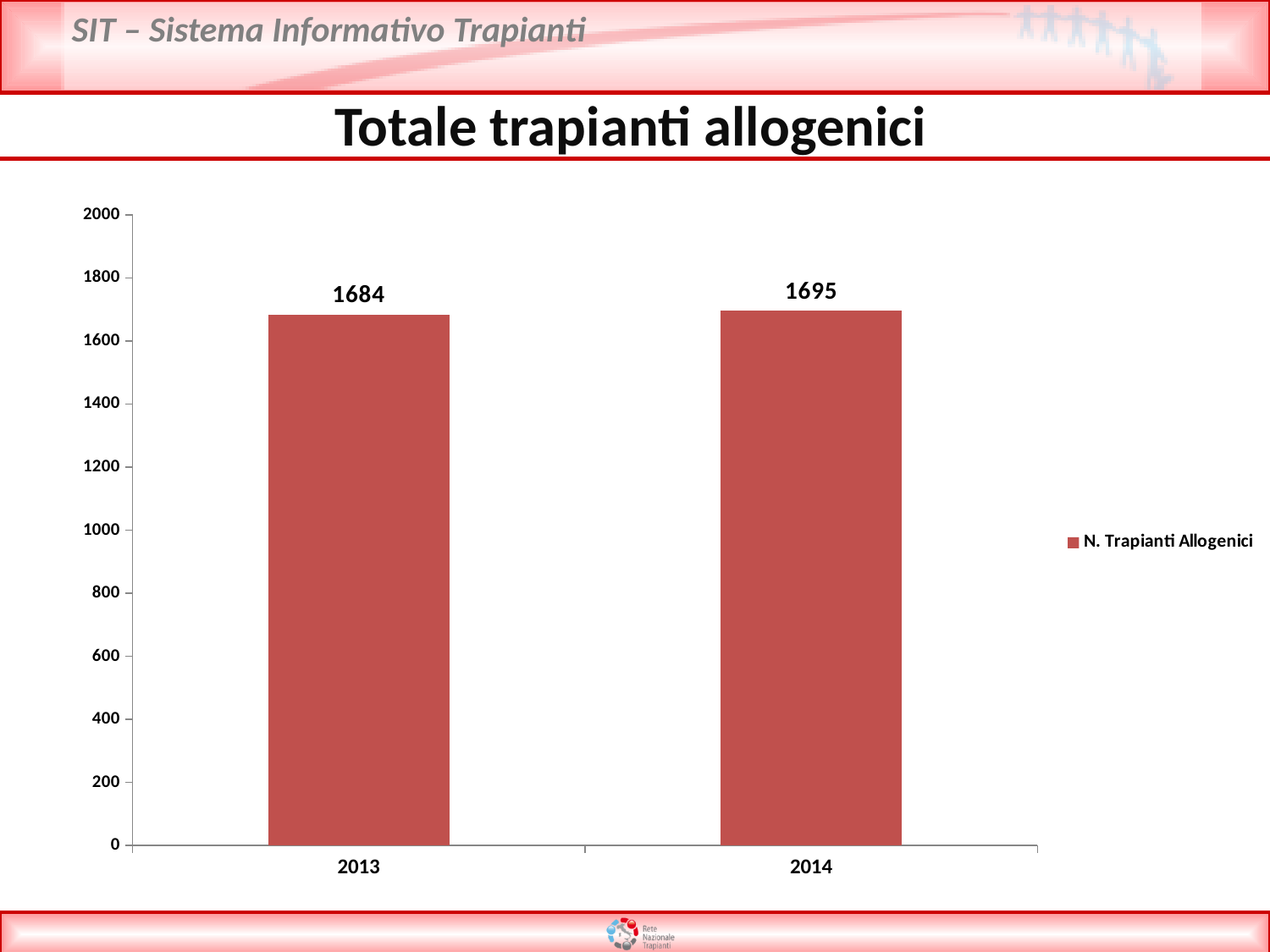
What is the title of the chart? Totale trapianti allogenici What is the difference between the values for 2014 and 2013? 11 What is the value for 2014? 1695 Do the values rise or fall from 2013 to 2014? rise Which year has the lower value? 2013 How many series does the legend list? 1 How many years are shown on the x axis? 2 Is the value for 2013 greater or less than 1800? less Is the value for 2014 greater or less than 1600? greater What is the value for 2013? 1684 Which year has the higher value? 2014 What kind of chart is shown? bar chart